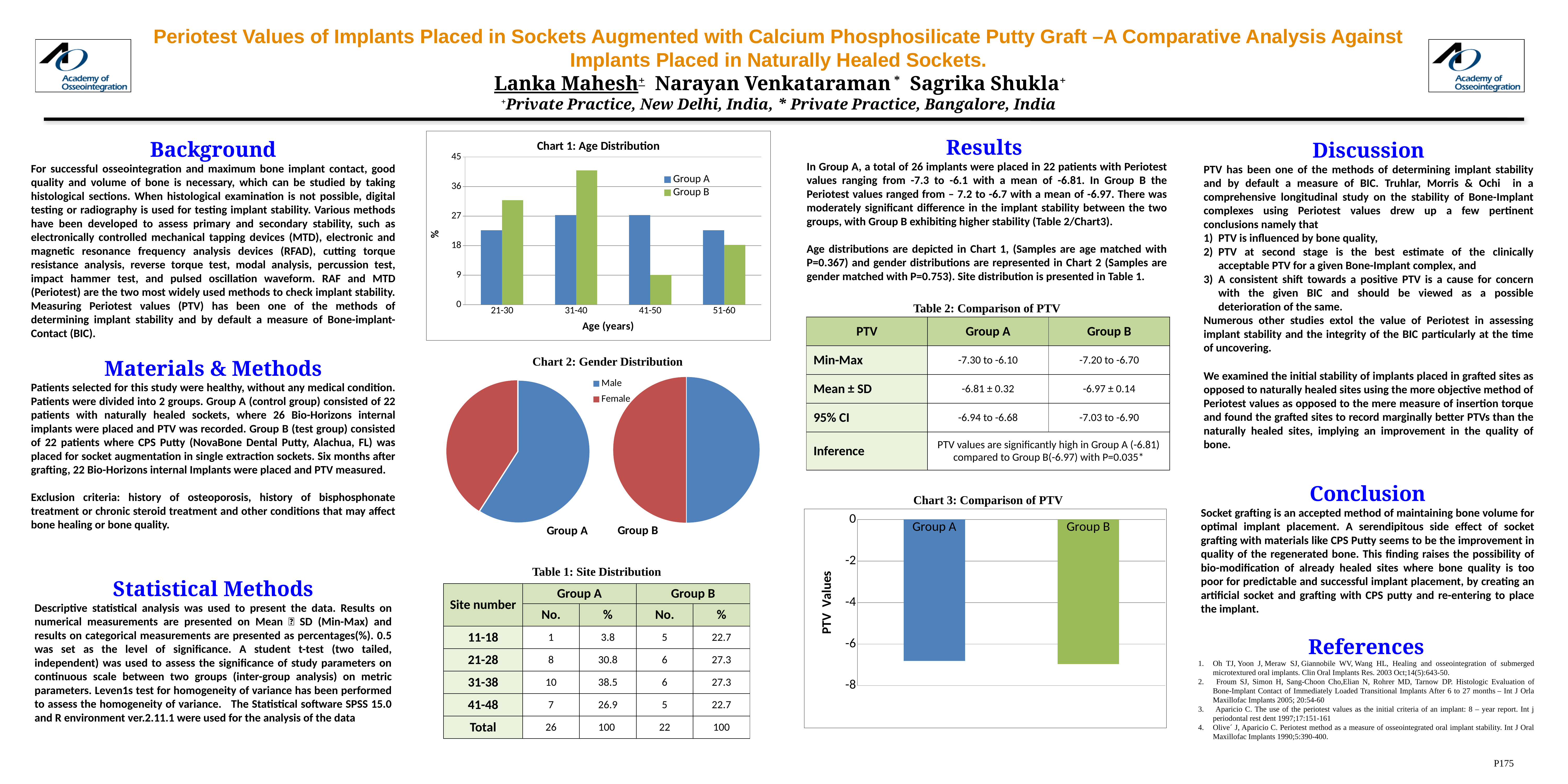
In Chart 1: Age Distribution, is the value for Group B in the 31-40 age group greater or less than 36? greater In Chart 1: Age Distribution, which is larger for the 41-50 age group, Group A or Group B? Group A In Chart 1: Age Distribution, is the value for Group A in the 21-30 age group greater or less than 27? less In Chart 2: Gender Distribution, which slice is larger in the Group A pie, Male or Female? Male What kind of chart is Chart 2: Gender Distribution? pie chart What is the label of the x axis in Chart 1: Age Distribution? Age (years) In Chart 1: Age Distribution, which age group has the highest value for Group B? 31-40 In Chart 1: Age Distribution, how many series does the legend list? 2 In Chart 1: Age Distribution, how many age categories are shown on the x axis? 4 What kind of chart is Chart 1: Age Distribution? bar chart In Chart 3: Comparison of PTV, is the value for Group A greater or less than -4? less In Chart 1: Age Distribution, which age group has the lowest value for Group B? 41-50